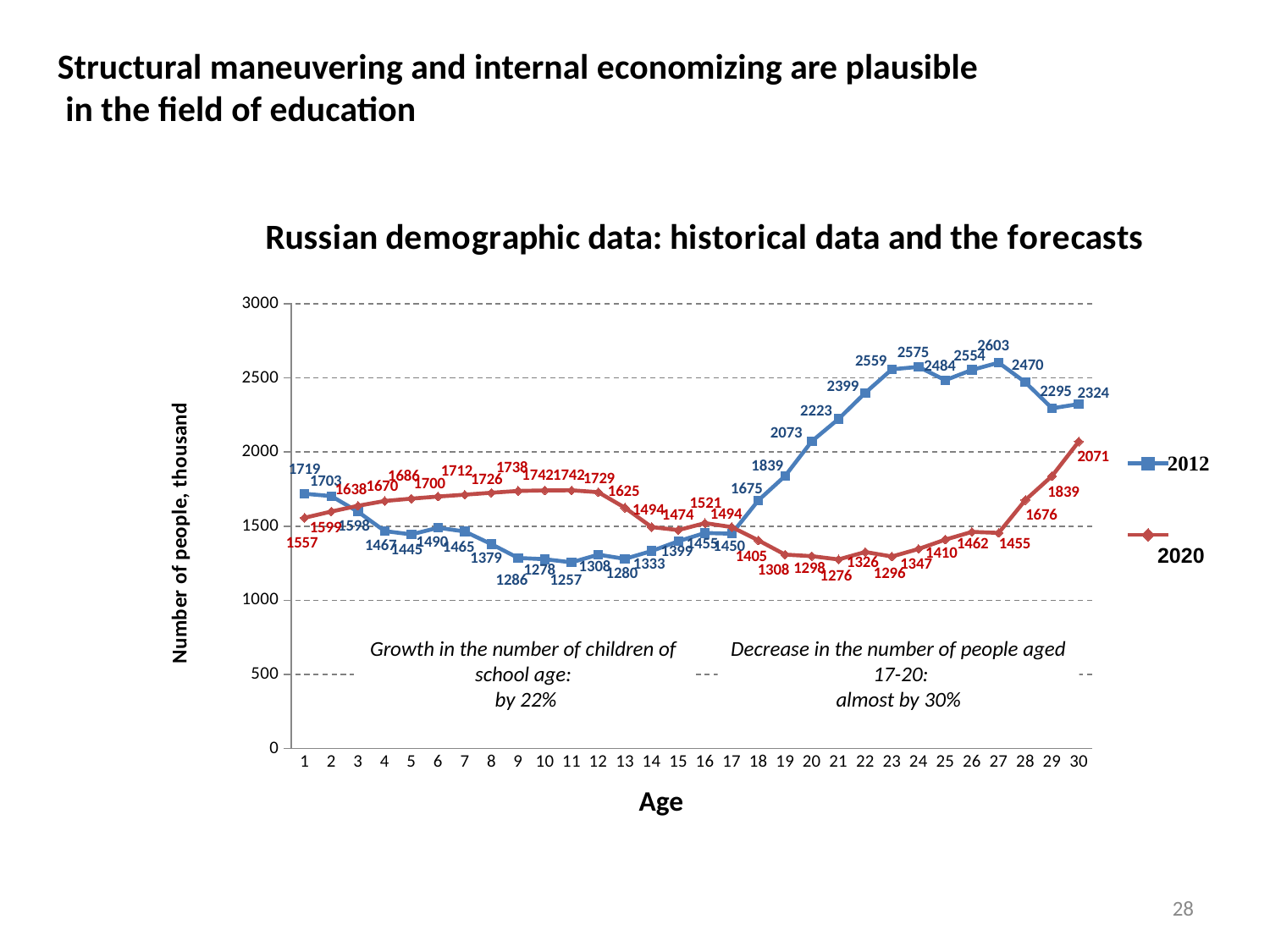
At which age does the 2012 series reach its lowest value? 11 At which age does the 2020 series reach its lowest value? 21 What is the difference between the 2012 and 2020 values at age 20? 775 At which age does the 2012 series reach its highest value? 27 Does the 2012 series rise or fall from age 17 to age 23? rise How many series does the legend list? 2 Which series has the larger value at age 10, 2012 or 2020? 2020 What is the value for the 2020 series at age 30? 2071 What type of chart is shown on the slide? line chart What is the title of the chart? Russian demographic data: historical data and the forecasts What is the value for the 2012 series at age 27? 2603 How many age categories are plotted on the x axis? 30